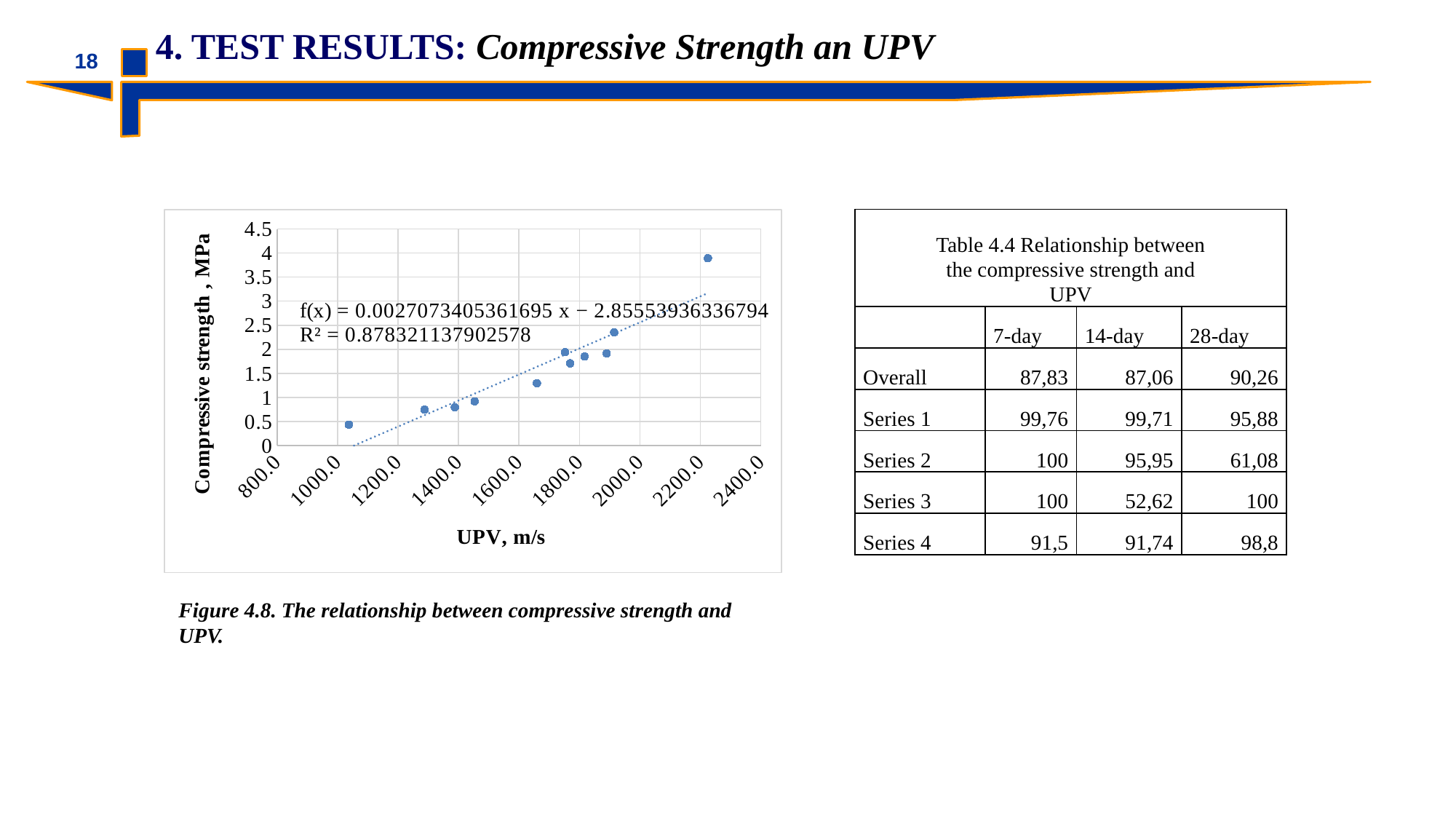
What is the label of the x axis of the chart? UPV, m/s What kind of chart is shown in Figure 4.8? scatter chart What is the R² value printed on the chart? 0.878321137902578 Is the highest plotted compressive strength greater or less than 3.5? greater Is the lowest plotted compressive strength greater or less than 1? less What is the label of the y axis of the chart? Compressive strength , MPa Is the UPV of the leftmost plotted point greater or less than 1200? less What is the intercept of the trendline equation printed on the chart? −2.85553936336794 In the chart, does compressive strength generally rise or fall as UPV increases? rise What is the slope of the trendline equation printed on the chart? 0.0027073405361695